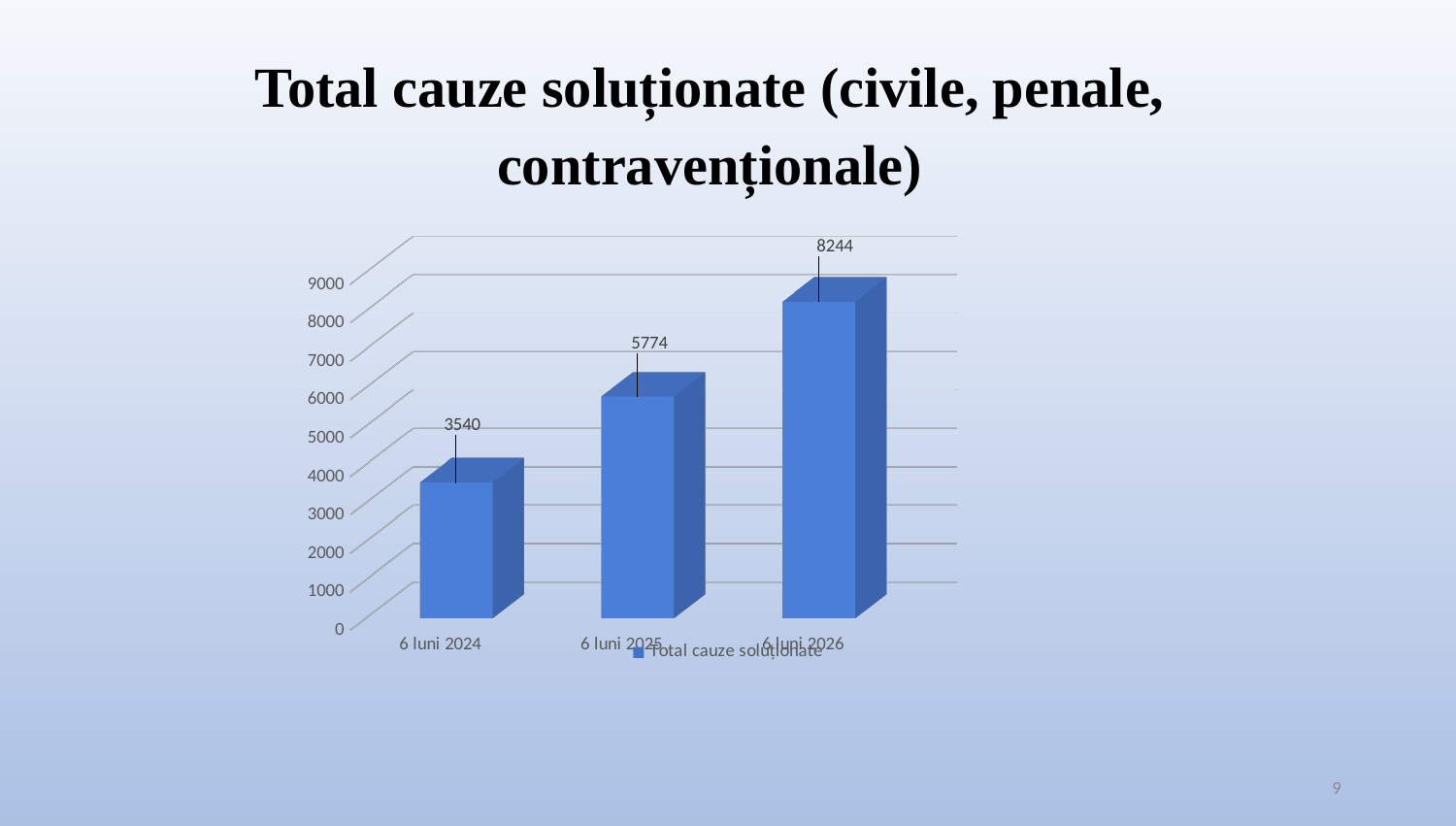
What series name does the legend show? Total cauze soluționate How many categories are shown on the x axis? 3 Do the values rise or fall from 6 luni 2024 to 6 luni 2026? rise Which category has the highest value? 6 luni 2026 What is the value for 6 luni 2024? 3540 What kind of chart is shown on the slide? bar chart What is the value for 6 luni 2026? 8244 Which category has the lowest value? 6 luni 2024 What is the value for 6 luni 2025? 5774 What is the difference between the values for 6 luni 2025 and 6 luni 2024? 2234 Which is larger, the value for 6 luni 2025 or the value for 6 luni 2026? 6 luni 2026 What is the difference between the values for 6 luni 2026 and 6 luni 2024? 4704